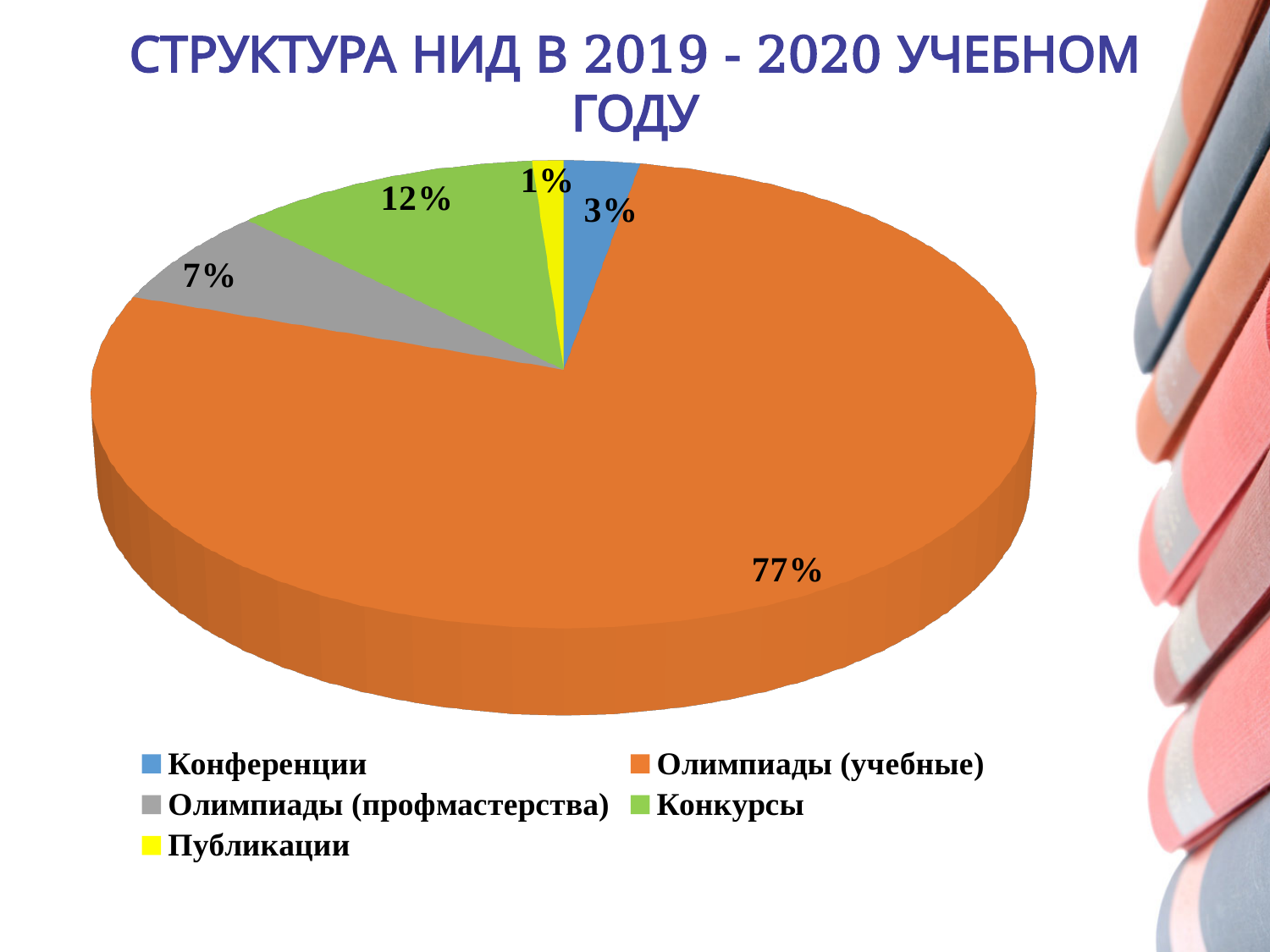
What kind of chart is shown on the slide? Pie chart What share of the pie does Конференции represent? 3% Which category has the largest slice of the pie? Олимпиады (учебные) What share of the pie does Олимпиады (учебные) represent? 77% What share of the pie does Олимпиады (профмастерства) represent? 7% Which is larger, the share for Конференции or the share for Конкурсы? Конкурсы What colour is the slice for Публикации? Yellow How many categories are shown in the pie chart? 5 What is the difference in percentage points between Конкурсы and Олимпиады (профмастерства)? 5% Which category has the smallest slice of the pie? Публикации